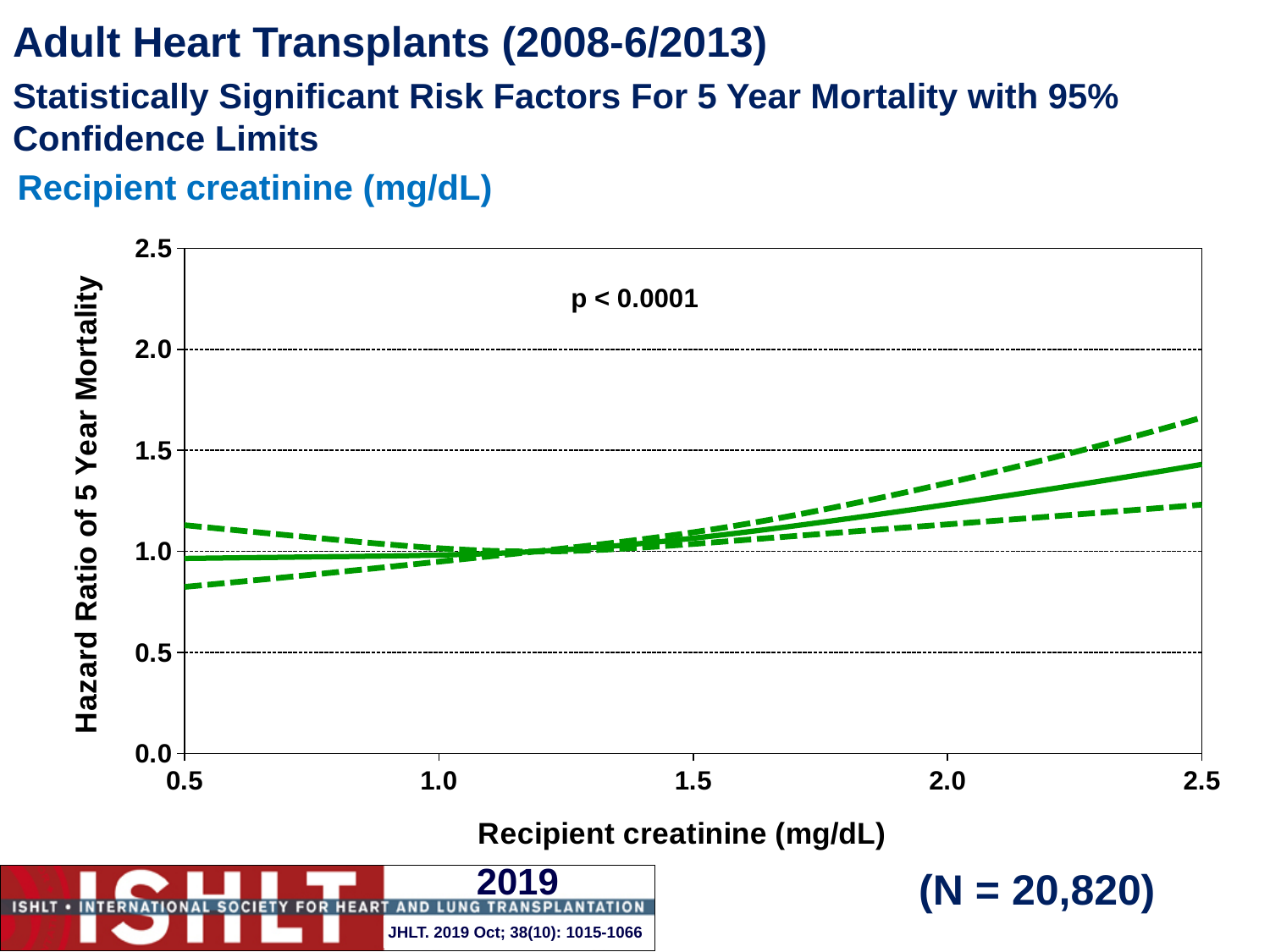
Is the hazard ratio (solid line) at a recipient creatinine of 2.5 mg/dL greater or less than 1.0? greater Is the upper 95% confidence limit (upper dashed line) at a recipient creatinine of 2.5 mg/dL greater or less than 1.5? greater Is the hazard ratio (solid line) higher at a recipient creatinine of 2.5 mg/dL or at 1.0 mg/dL? 2.5 mg/dL What p-value is printed on the chart? p < 0.0001 What is the label of the y axis? Hazard Ratio of 5 Year Mortality What kind of chart is shown on the slide? line chart Does the solid hazard ratio line rise or fall as recipient creatinine increases from 0.5 to 2.5 mg/dL? rise Is the lower 95% confidence limit (lower dashed line) at a recipient creatinine of 0.5 mg/dL greater or less than 1.0? less How many lines are plotted on the chart? 3